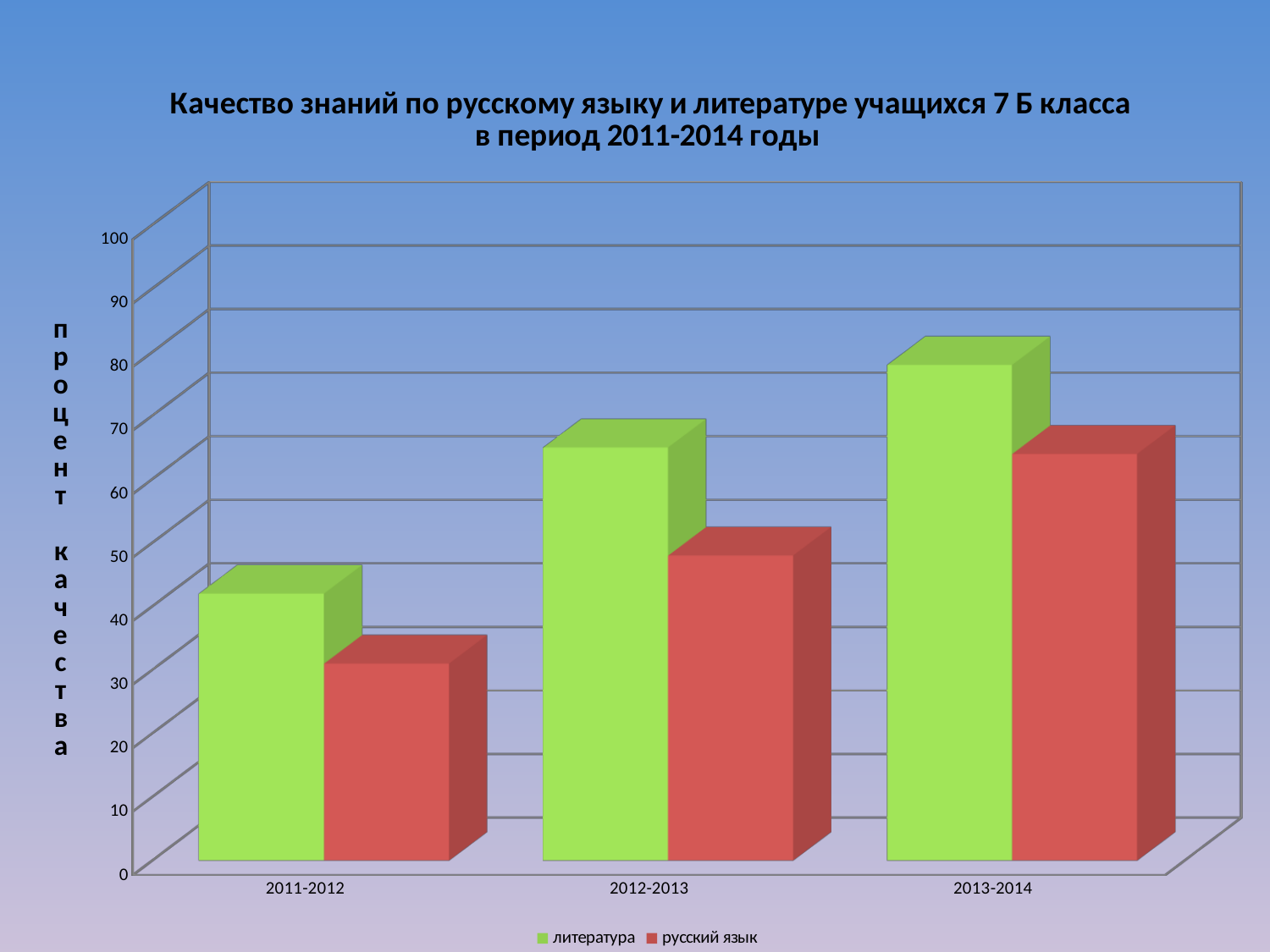
Which colour represents русский язык in the legend? red Do the values for русский язык rise or fall from 2011-2012 to 2013-2014? rise In 2012-2013, which is larger: литература or русский язык? литература Is the value for русский язык in 2012-2013 greater or less than 60? less Which school year has the highest value for литература? 2013-2014 Which school year has the lowest value for русский язык? 2011-2012 How many school-year categories are shown on the x axis? 3 Is the value for литература in 2013-2014 greater or less than 70? greater Is the value for литература in 2011-2012 greater or less than 50? less What kind of chart is shown on the slide? bar chart How many series does the legend list? 2